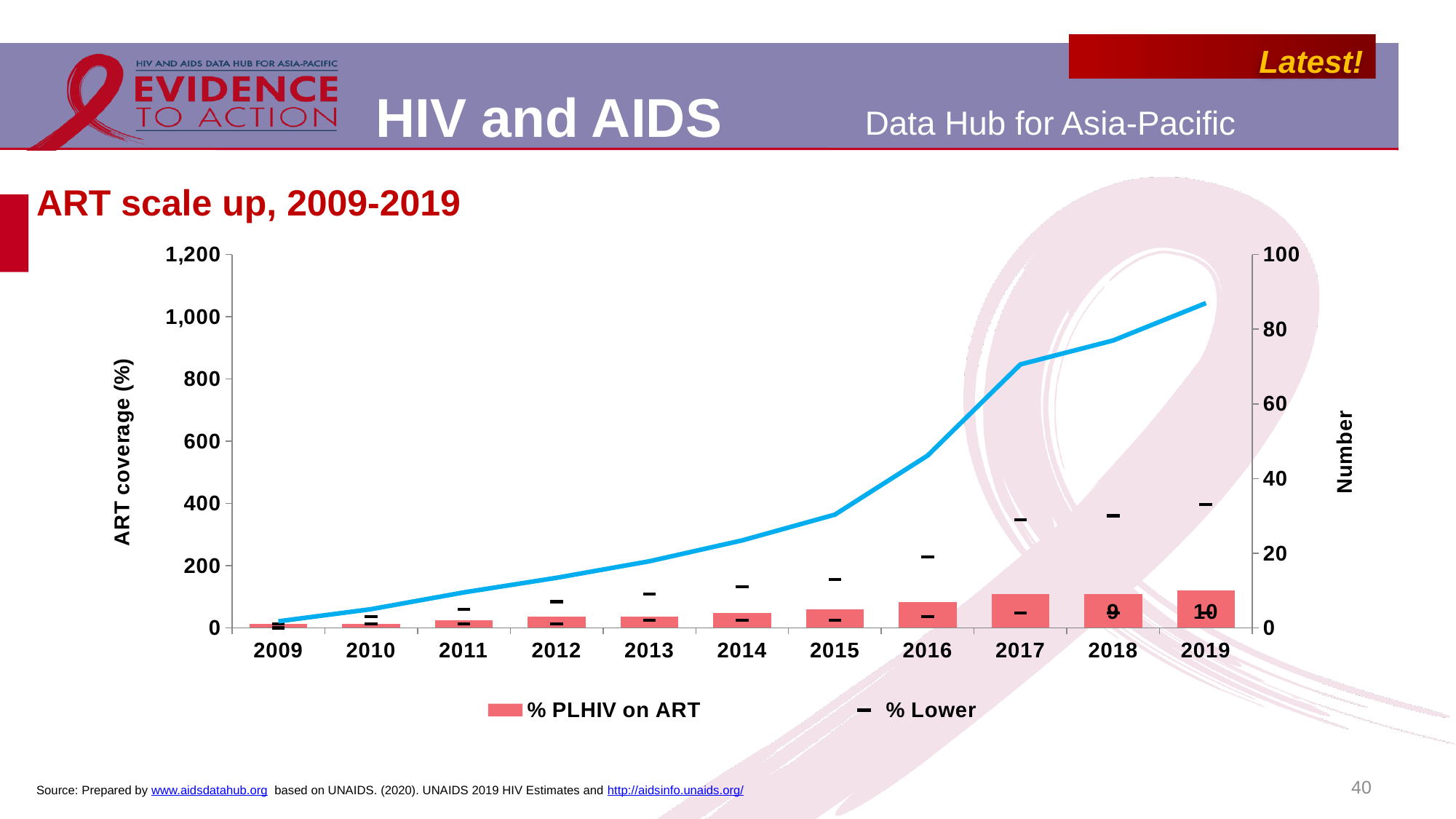
Which is larger, the % PLHIV on ART bar for 2019 or for 2013? 2019 What label is shown on the right-hand vertical axis of the chart? Number Which year has the tallest % PLHIV on ART bar? 2019 Is the blue line value for 2019 on the right-hand axis greater or less than 80? greater Is the blue line value for 2017 on the right-hand axis greater or less than 80? less What is the title of the chart? ART scale up, 2009-2019 Is the blue line value for 2015 on the right-hand axis greater or less than 40? less What are the two entries in the chart legend? % PLHIV on ART and % Lower Do the % PLHIV on ART bars generally rise or fall from 2009 to 2019? rise How many years are shown on the x axis of the chart? 11 Does the blue line rise or fall from 2009 to 2019? rises How many series does the chart legend list? 2